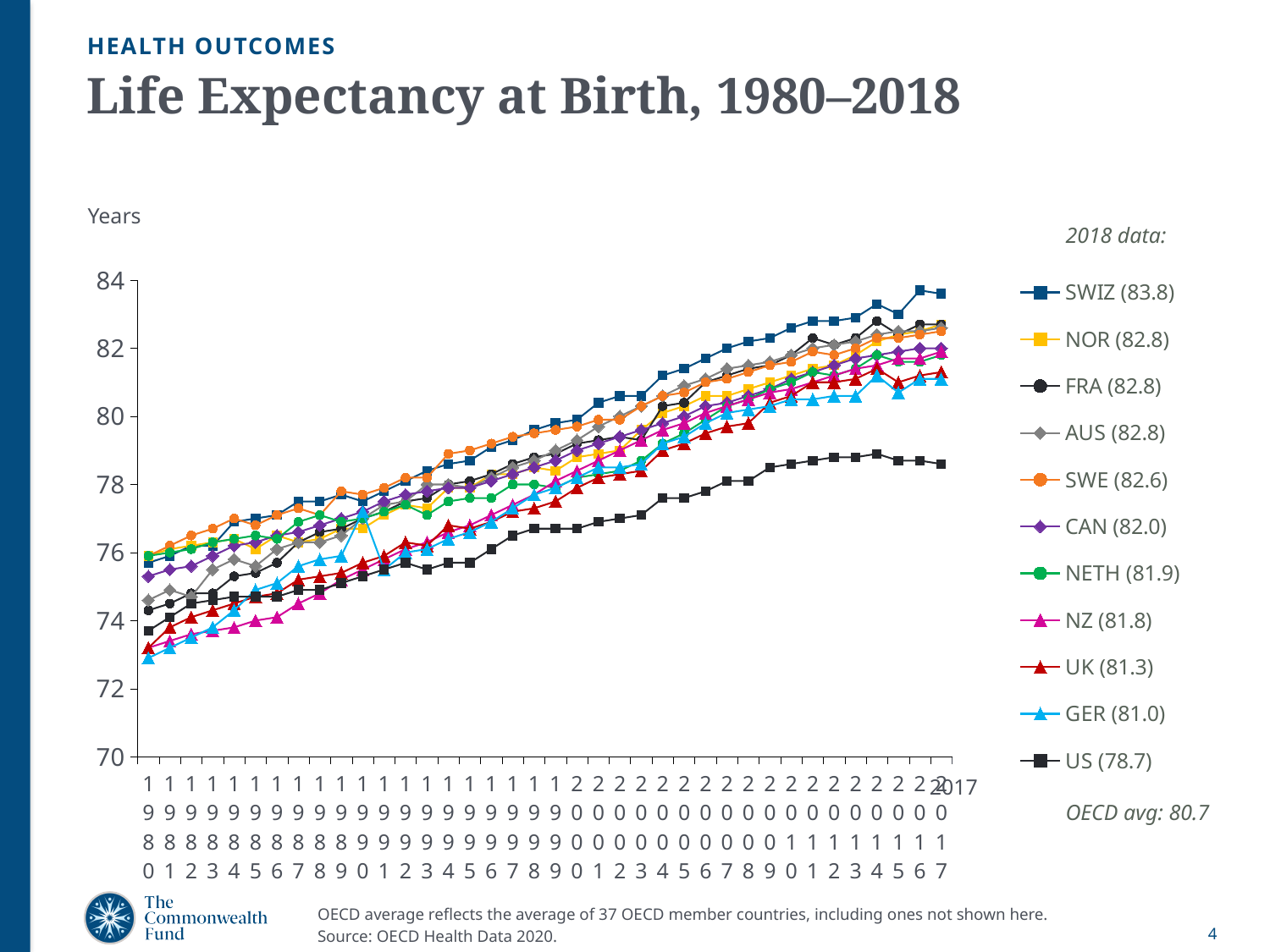
Is the value for the US in 2000 greater or less than 78? less What is the difference between the 2018 life expectancy of SWIZ and the US? 5.1 How many countries does the legend list? 11 What type of chart is shown on the slide? line chart Is the value for SWE in 1990 greater or less than 76? greater Which country had the highest life expectancy in 2018? SWIZ What OECD average is noted on the slide? 80.7 Which had a higher life expectancy in 2018, NOR or CAN? NOR Which country had the lowest life expectancy in 2018? US According to the legend, what was life expectancy at birth in Switzerland (SWIZ) in 2018? 83.8 According to the legend, what was life expectancy at birth in the US in 2018? 78.7 Do the life expectancy values generally rise or fall from 1980 to 2018? rise